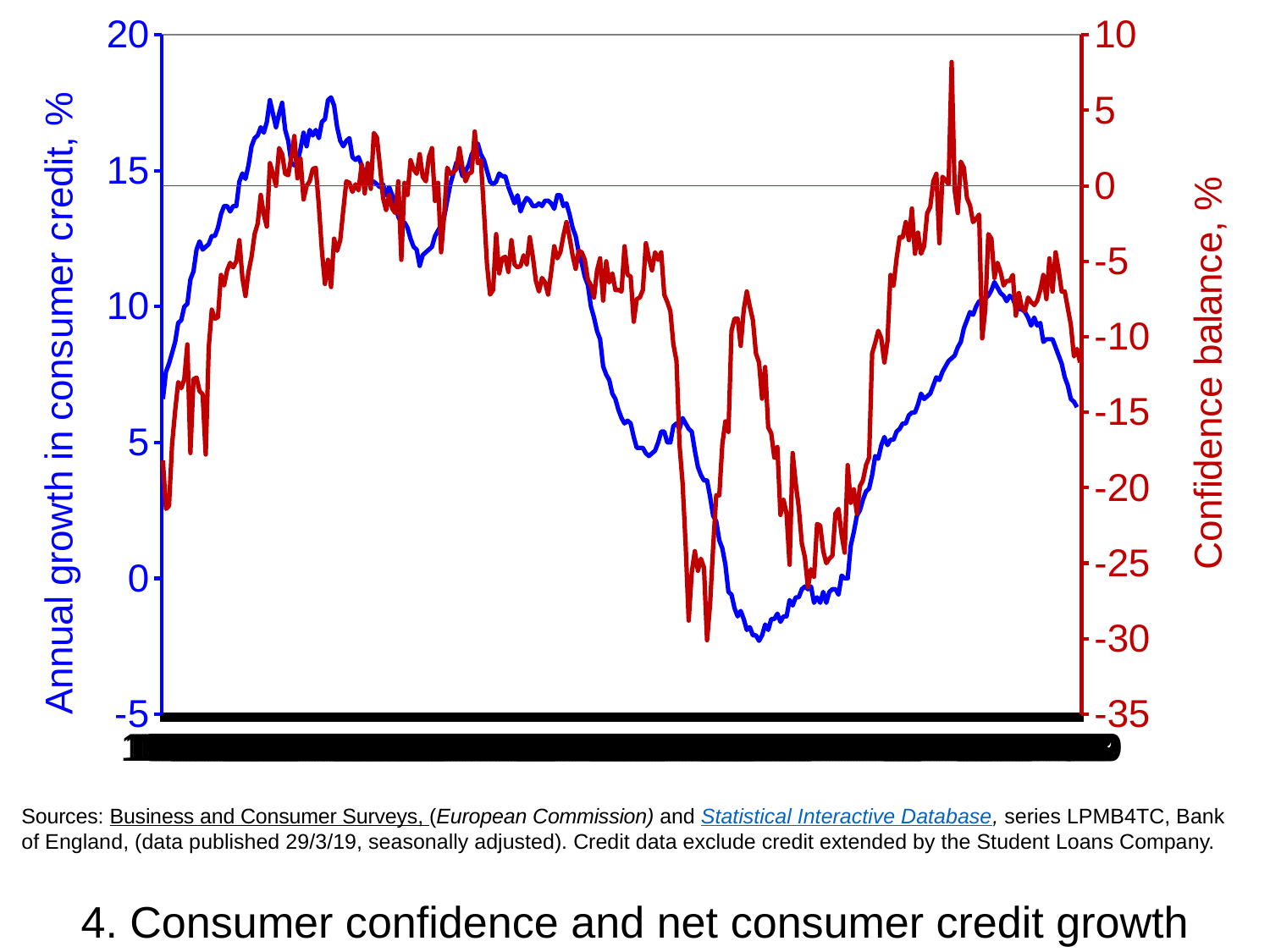
What is the label of the right vertical axis? Confidence balance, % How many lines are plotted on the chart? 2 What is the lowest tick value shown on the right vertical axis? -35 Is the peak of the blue line (annual growth in consumer credit) greater or less than 15 on the left axis? greater What kind of chart is shown on the slide? line chart What is the highest tick value shown on the left vertical axis? 20 Is the lowest point of the red line (confidence balance) greater or less than -25 on the right axis? less Is the lowest point of the blue line (annual growth in consumer credit) greater or less than 0 on the left axis? less Does the blue line (annual growth in consumer credit) end higher or lower than its peak at the right end of the chart? lower